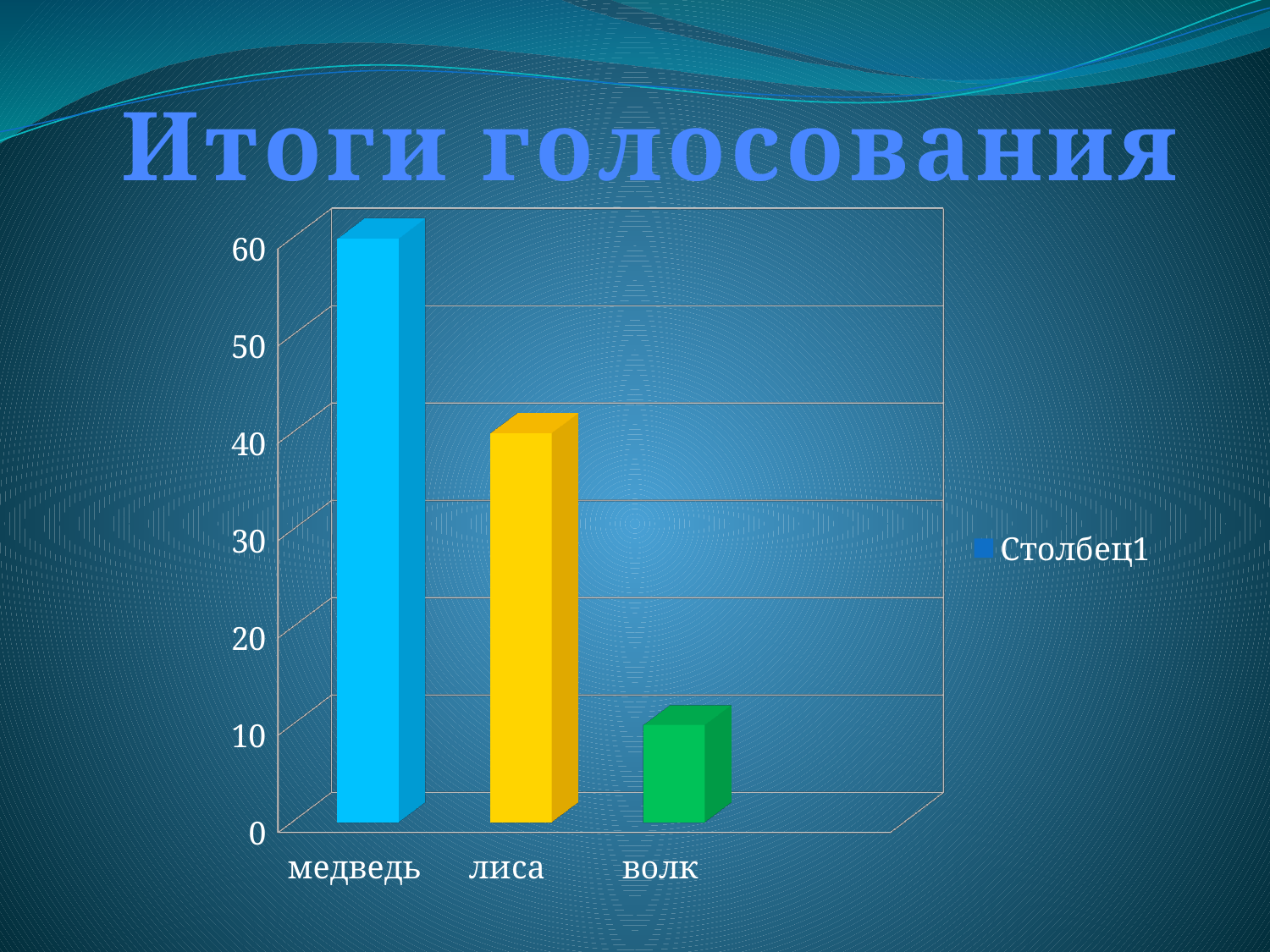
What kind of chart is shown on the slide? bar chart What is the title of the slide above the chart? Итоги голосования What is the value for волк? 10 What is the difference between the values for лиса and волк? 30 Which is larger, the value for лиса or the value for волк? лиса What is the value for медведь? 60 Which category has the highest value? медведь Is the value for медведь greater or less than 50? greater How many categories are shown on the x axis? 3 What is the difference between the values for медведь and лиса? 20 What is the value for лиса? 40 Which category has the lowest value? волк